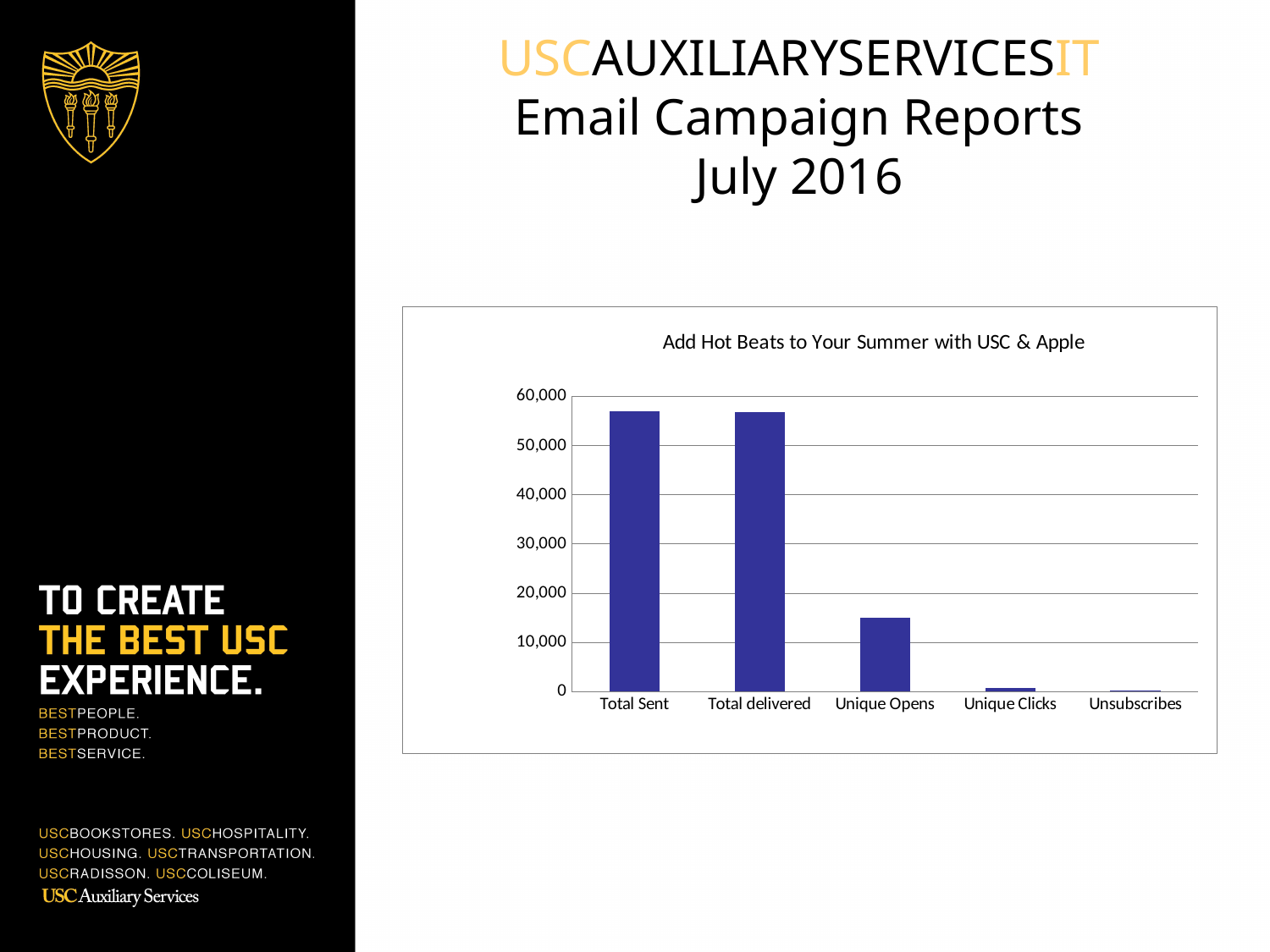
What is the title of the chart? Add Hot Beats to Your Summer with USC & Apple Is the value for Total delivered greater or less than 60,000? less Which is larger, the value for Total Sent or the value for Unique Opens? Total Sent Which is larger, the value for Unique Opens or the value for Unique Clicks? Unique Opens What kind of chart is shown on the slide? bar chart How many categories are shown on the x axis of the chart? 5 Is the value for Unique Opens greater or less than 20,000? less Is the value for Unique Opens greater or less than 10,000? greater Do the values rise or fall moving from left to right along the x axis? fall Which category has the lowest value in the chart? Unsubscribes